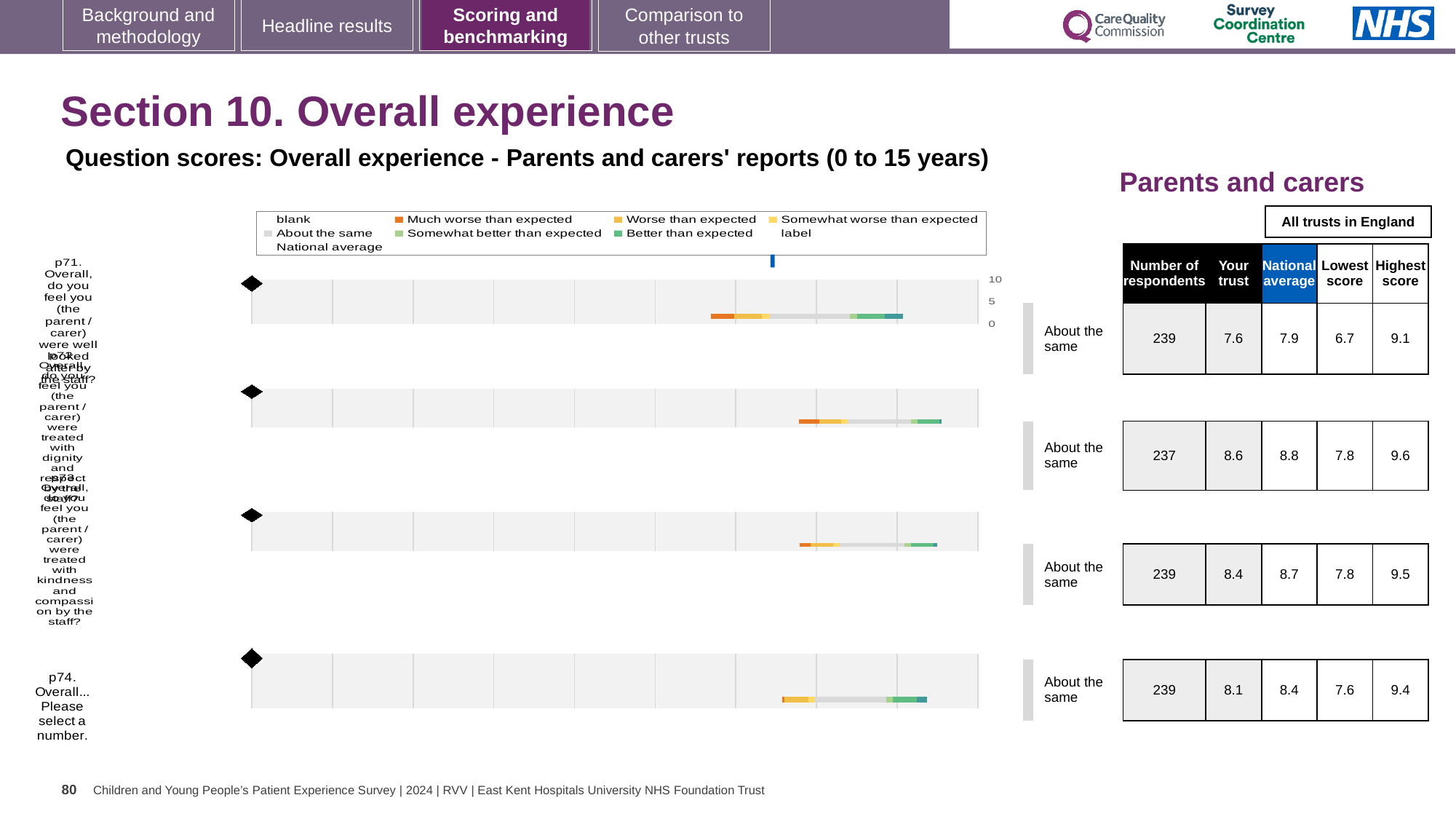
What is the difference between the national average and the 'Your trust' score for p71? 0.3 According to the table, what is the national average for p74 (Overall... Please select a number)? 8.4 What colour does the legend use for 'Much worse than expected'? orange How many questions (rows) are plotted in the chart? 4 For p74, which is larger: the 'Your trust' score or the national average? National average (8.4) Is the 'Your trust' score for p71 greater or less than 5 on the chart's axis? greater Which row has the lowest 'Your trust' score in the table? p71 (7.6) What comparison label is shown next to the p71 row? About the same According to the table, what is the 'Your trust' score for p71 (Overall, do you feel you were well looked after by the staff?)? 7.6 What kind of chart is used to show the question scores on this slide? bar chart How many respondents answered p74 (Overall... Please select a number)? 239 Which row has the highest 'Your trust' score in the table? the second row (8.6)